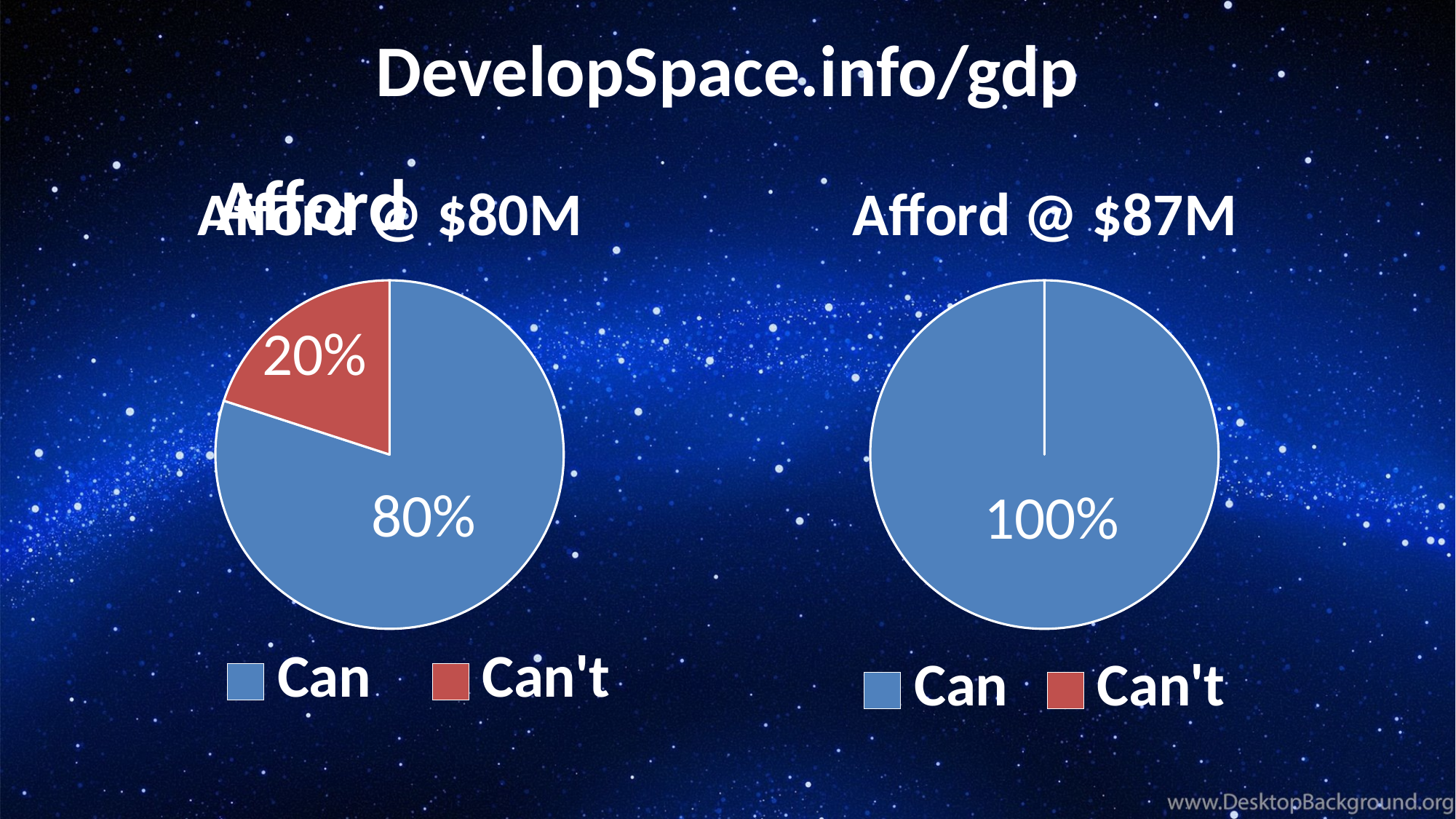
In the 'Afford @ $80M' chart, what percentage is shown for the 'Can' slice? 80% How many entries does the legend of the 'Afford @ $80M' chart list? 2 In the 'Afford @ $80M' chart, what is the difference between the 'Can' and 'Can't' percentages? 60% What type of chart is the 'Afford @ $87M' chart? Pie chart In the 'Afford @ $80M' chart, which category has the largest slice? Can In the 'Afford @ $80M' chart, what colour is the 'Can't' slice? Red In the 'Afford @ $80M' chart, which is larger, 'Can' or 'Can't'? Can In the 'Afford @ $80M' chart, what percentage is shown for the 'Can't' slice? 20% How many charts are shown on the slide? 2 In the 'Afford @ $80M' chart, which category has the smallest slice? Can't In the 'Afford @ $87M' chart, what percentage is shown for the 'Can' slice? 100% What is the title of the chart on the right side of the slide? Afford @ $87M